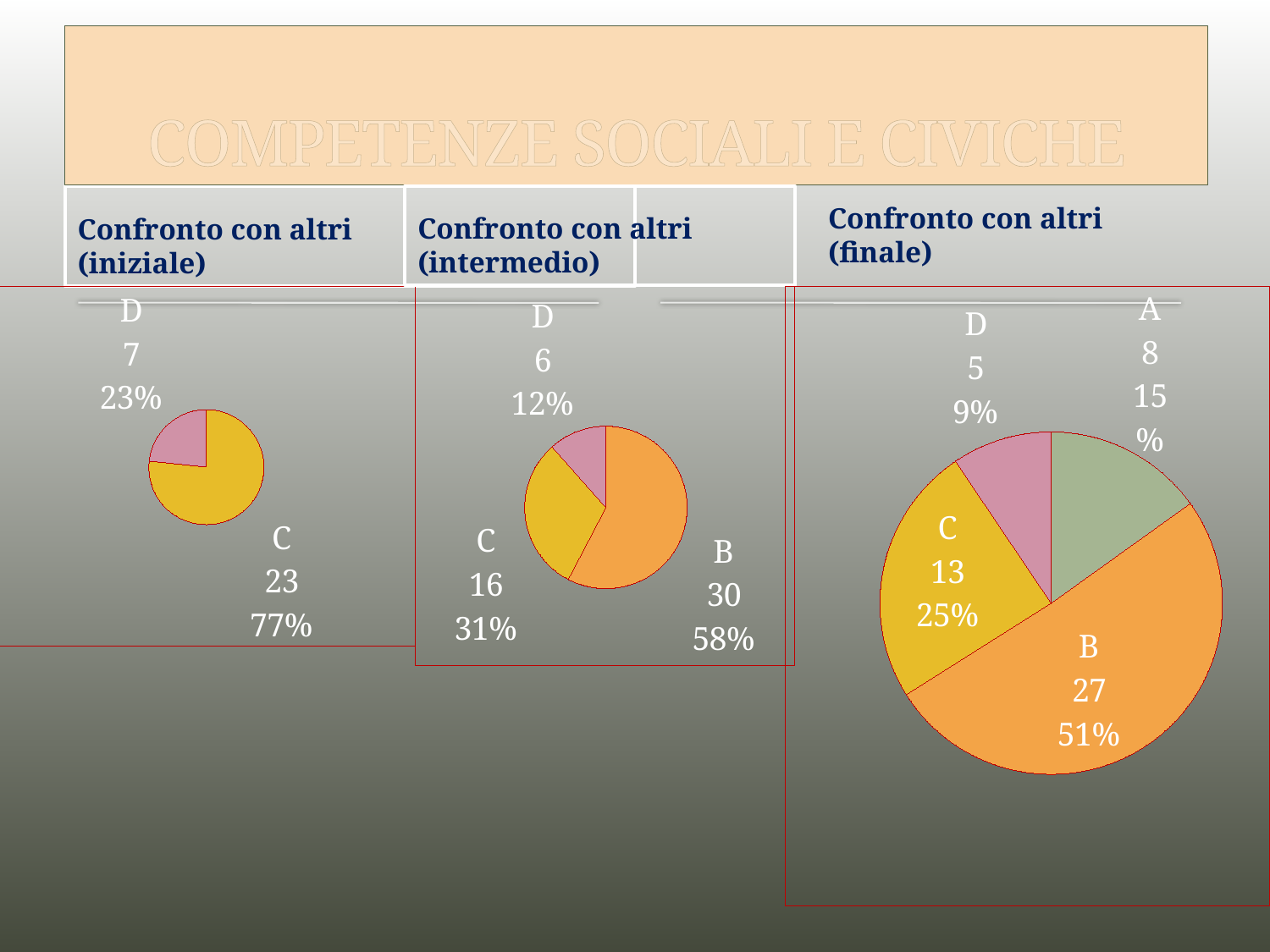
In the 'Confronto con altri (intermedio)' chart, what is the difference between the values for B and C? 14 In the 'Confronto con altri (intermedio)' chart, what share of the pie does category C have? 31% In the 'Confronto con altri (intermedio)' chart, what value is shown for category B? 30 In the 'Confronto con altri (intermedio)' chart, which category has the smallest slice? D How many slices does the 'Confronto con altri (iniziale)' pie chart have? 2 How many categories does the 'Confronto con altri (finale)' pie chart have? 4 In the 'Confronto con altri (finale)' chart, what value is shown for category A? 8 In the 'Confronto con altri (finale)' chart, which is larger, the value for C or the value for D? C In the 'Confronto con altri (iniziale)' chart, what share of the pie does category D have? 23% In the 'Confronto con altri (finale)' chart, which category has the largest slice? B What type of chart is used for 'Confronto con altri (finale)'? Pie chart In the 'Confronto con altri (iniziale)' chart, what value is shown for category C? 23